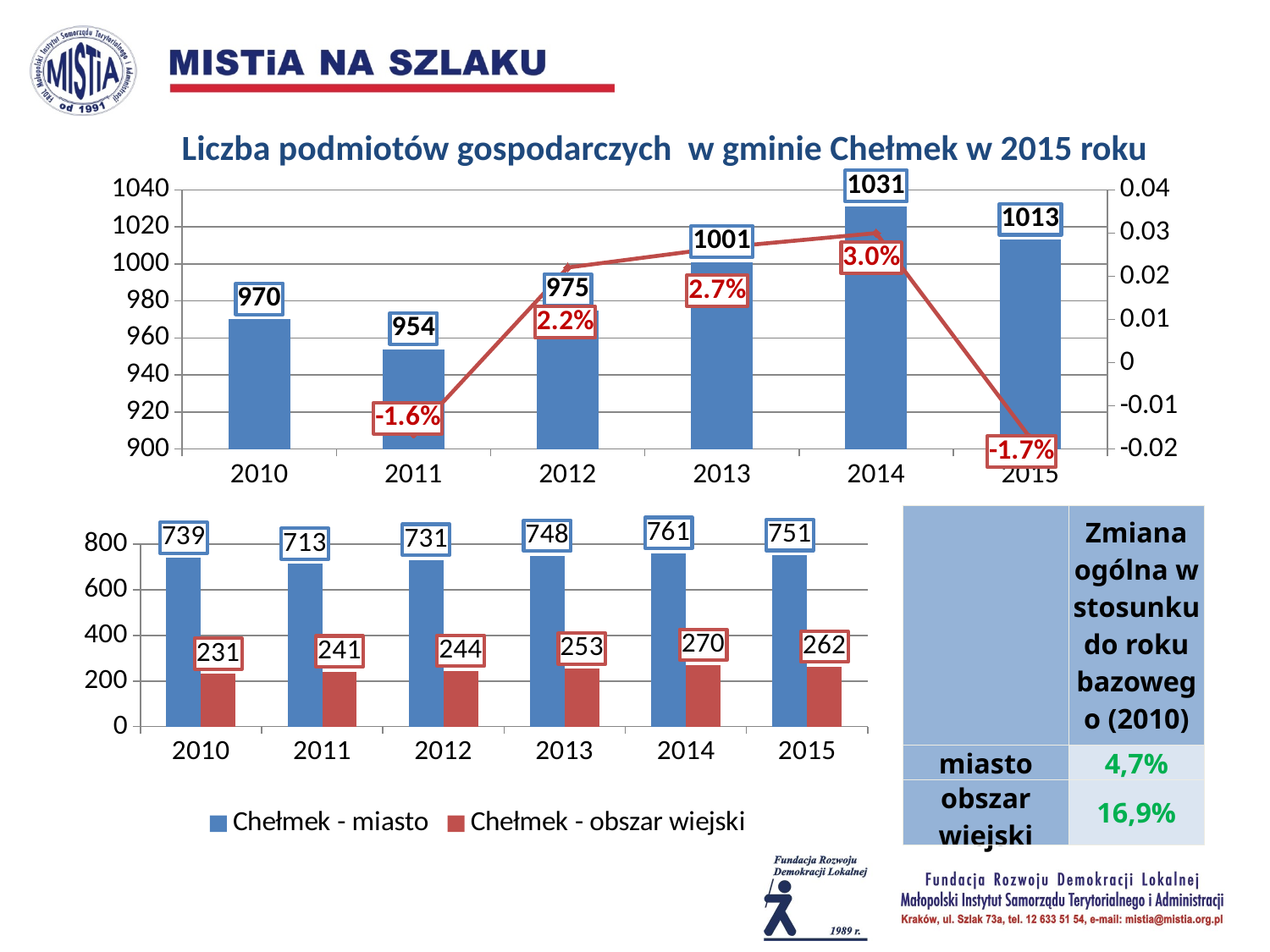
In the bottom chart, what is the value for Chełmek - obszar wiejski in 2014? 270 In the top chart, what is the value of the bar for 2014? 1031 In the top chart, what percentage change is shown on the line for 2015? -1.7% In the bottom chart, how many series does the legend list? 2 In the bottom chart, what is the value for Chełmek - miasto in 2011? 713 What type of chart is the bottom chart? bar chart In the bottom chart, what is the difference between Chełmek - miasto and Chełmek - obszar wiejski in 2015? 489 In the bottom chart, which year has the highest value for Chełmek - miasto? 2014 In the top chart, which year has the lowest bar value? 2011 In the top chart, how many years are shown on the x axis? 6 In the top chart, what percentage change is shown on the line for 2013? 2.7% In the top chart, what is the difference between the bar values for 2014 and 2010? 61